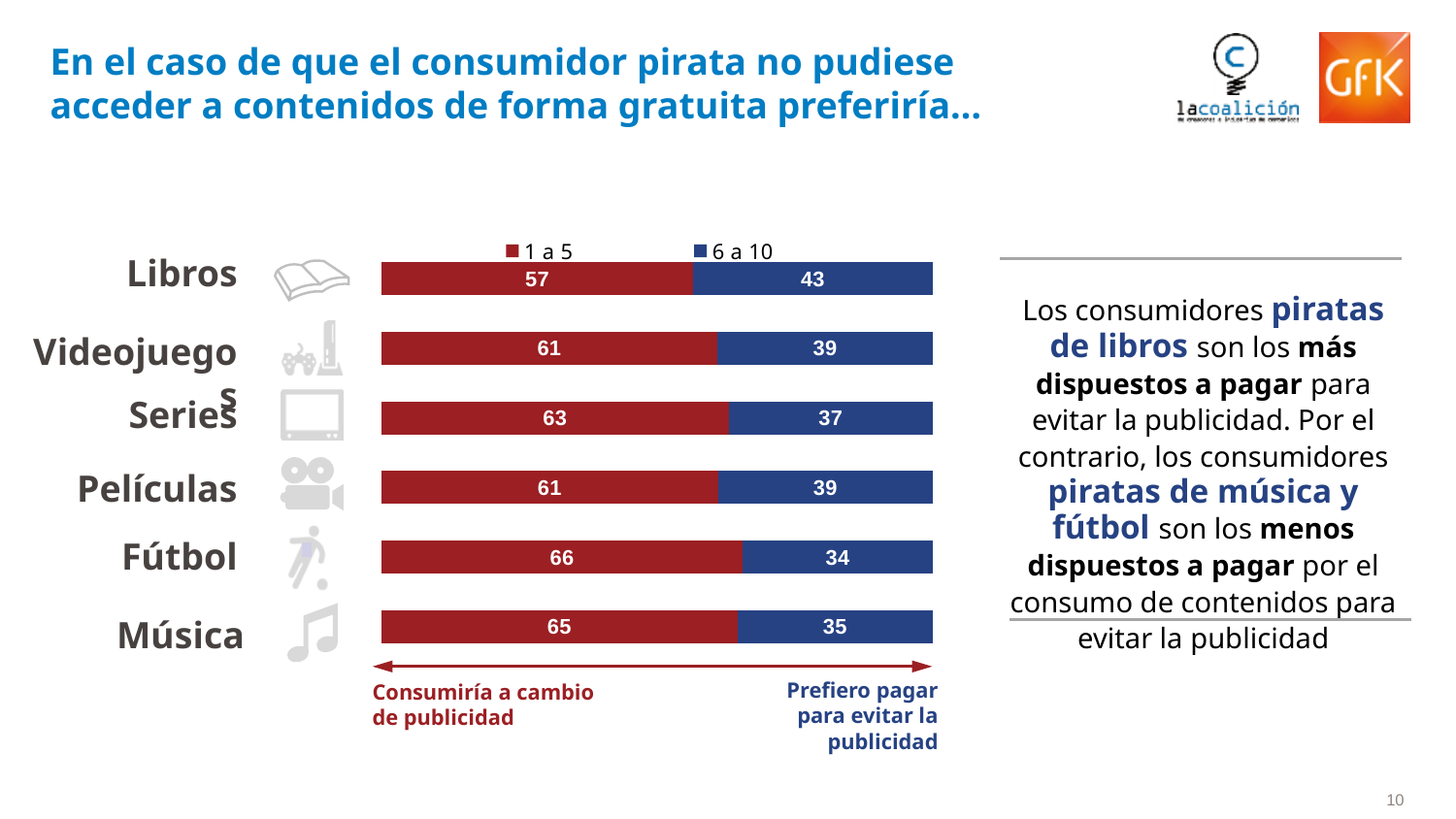
What is the value of the "6 a 10" series for Fútbol? 34 Which category has the lowest value in the "1 a 5" series? Libros What is the value of the "1 a 5" series for Libros? 57 What is the value of the "1 a 5" series for Series? 63 What kind of chart is shown on the slide? Stacked bar chart What is the difference between the "1 a 5" values for Fútbol and Libros? 9 What is the value of the "6 a 10" series for Música? 35 How many series does the legend list? 2 How many categories are shown in the chart? 6 Which category has the highest value in the "1 a 5" series? Fútbol Which is larger: the "6 a 10" value for Series or for Películas? Películas Which category has the highest value in the "6 a 10" series? Libros